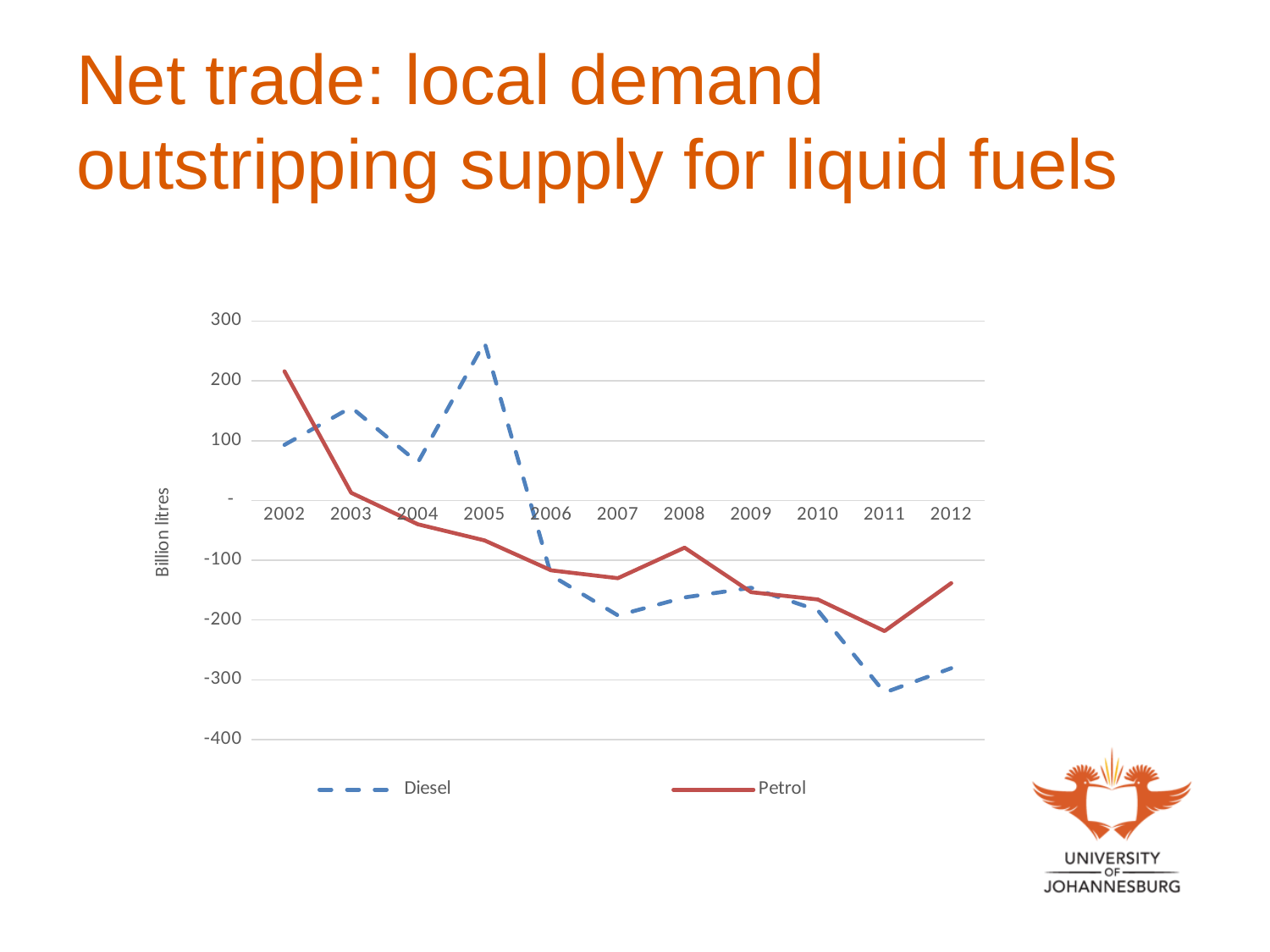
How many years are plotted along the x axis? 11 In which year does the Petrol series reach its highest value? 2002 In which year does the Diesel series reach its highest value? 2005 Is the Diesel value for 2005 greater or less than 200? greater In which year does the Petrol series reach its lowest value? 2011 In which year does the Diesel series reach its lowest value? 2011 What is the label on the vertical axis of the chart? Billion litres What kind of chart is shown on the slide? Line chart How many series does the legend list? 2 Which series has the higher value in 2002, Diesel or Petrol? Petrol Do the values of the Petrol series generally rise or fall from 2002 to 2012? Fall Is the Diesel value for 2011 greater or less than -300? less